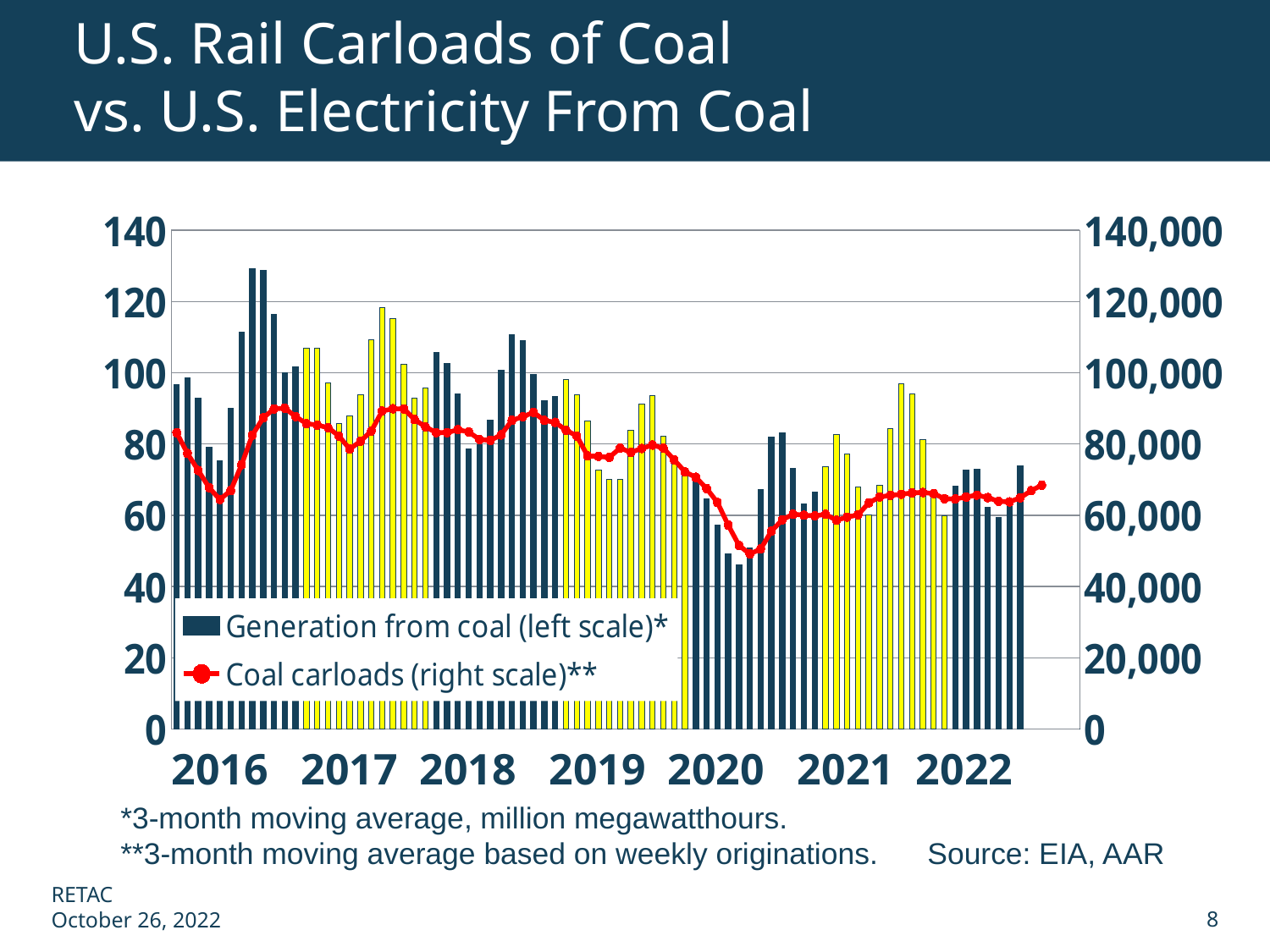
Is the peak of the coal carloads line in 2016 greater or less than 80,000 on the right scale? greater Is the lowest generation-from-coal bar in 2020 greater or less than 60 on the left scale? less Overall, do the generation-from-coal bars rise or fall from 2016 to 2022? fall How many year labels are shown along the x axis? 7 Which series is plotted on the right scale according to the legend? Coal carloads (right scale)** How many series does the legend list? 2 In which year do the generation-from-coal bars reach their highest level? 2016 What is the title of the chart? U.S. Rail Carloads of Coal vs. U.S. Electricity From Coal What kind of chart is shown on the slide? A combined bar and line chart Is the lowest point of the coal carloads line in 2020 greater or less than 60,000 on the right scale? less In which year do the generation-from-coal bars reach their lowest level? 2020